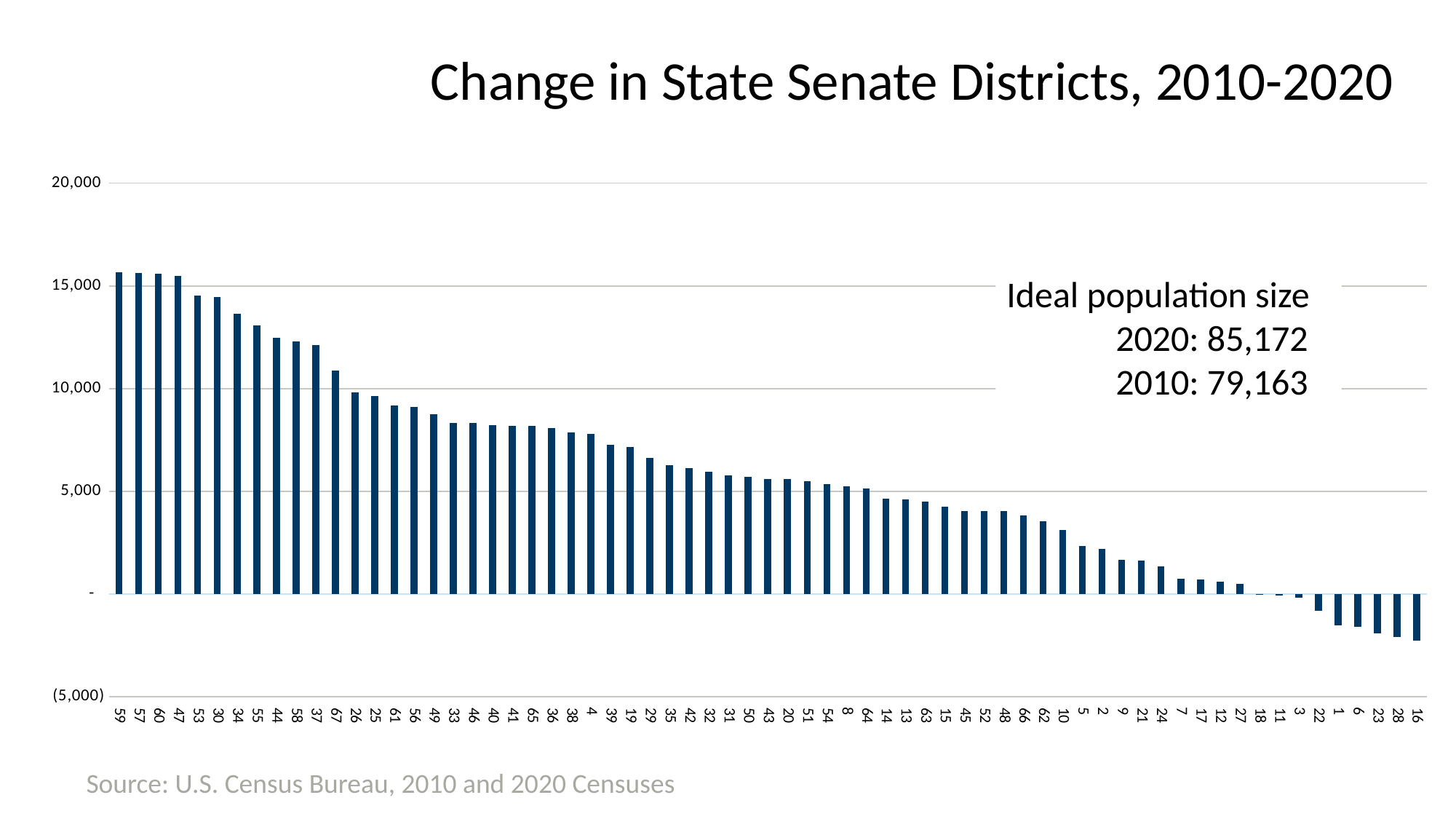
How many state senate districts are plotted on the x axis? 67 Is the value for district 16 greater or less than 0? less Is the value for district 7 greater or less than 5,000? less Is the value for district 67 greater or less than 10,000? greater What type of chart is shown on the slide? Bar chart Do the values rise or fall moving from left to right along the x axis? Fall What is the title of the chart? Change in State Senate Districts, 2010-2020 Which is larger, the value for district 53 or the value for district 26? District 53 According to the text on the slide, what is the ideal population size for 2020? 85,172